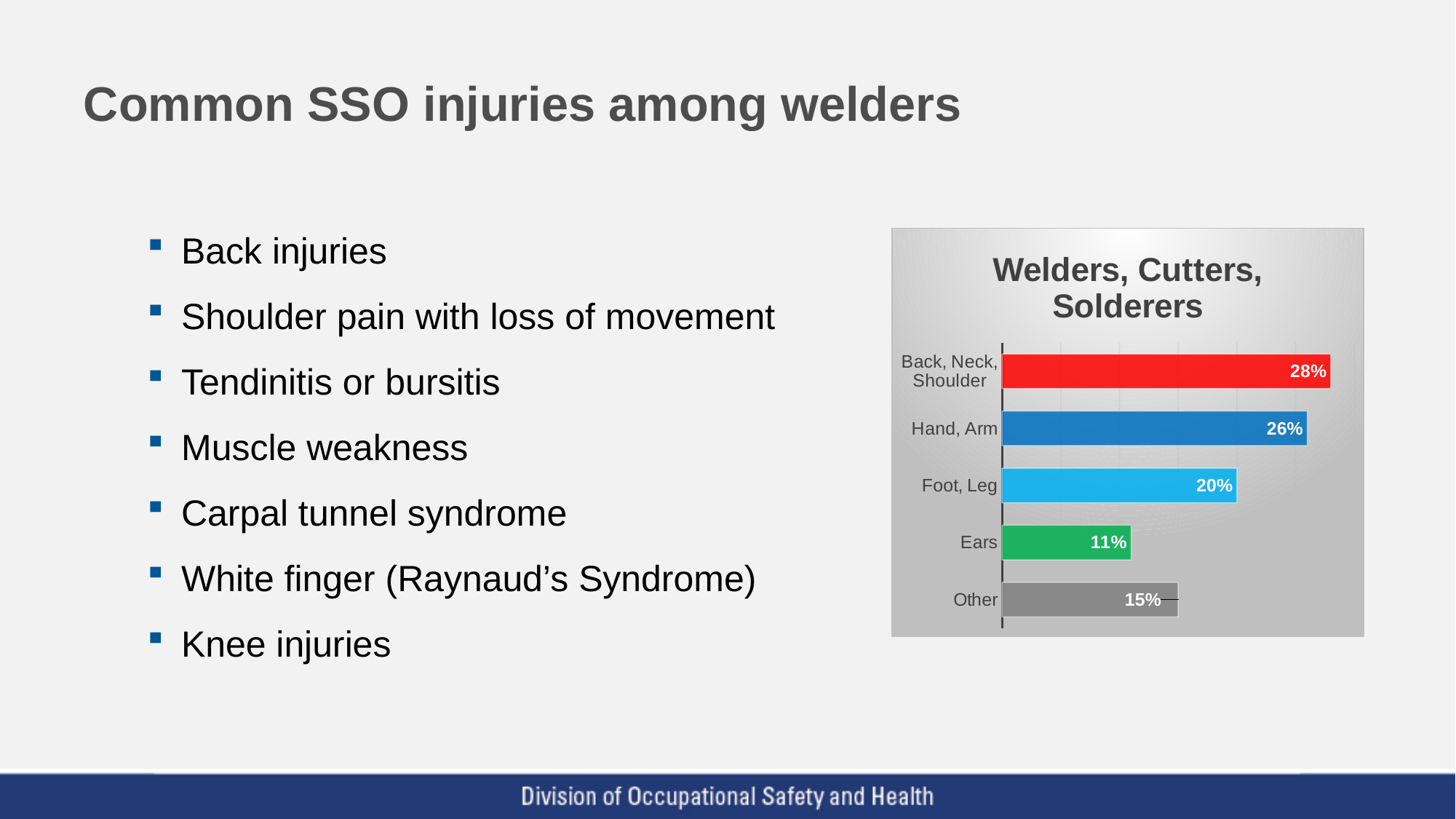
What kind of chart is shown on the slide? Bar chart Which category has the lowest value? Ears What is the title of the chart? Welders, Cutters, Solderers What is the value for Hand, Arm? 26% What is the difference between the values for Back, Neck, Shoulder and Foot, Leg? 8% What is the value for Back, Neck, Shoulder? 28% What is the value for Ears? 11% What is the value for Foot, Leg? 20% What is the value for Other? 15% Which is larger, the value for Other or the value for Ears? Other How many categories are shown in the chart? 5 Which category has the highest value? Back, Neck, Shoulder